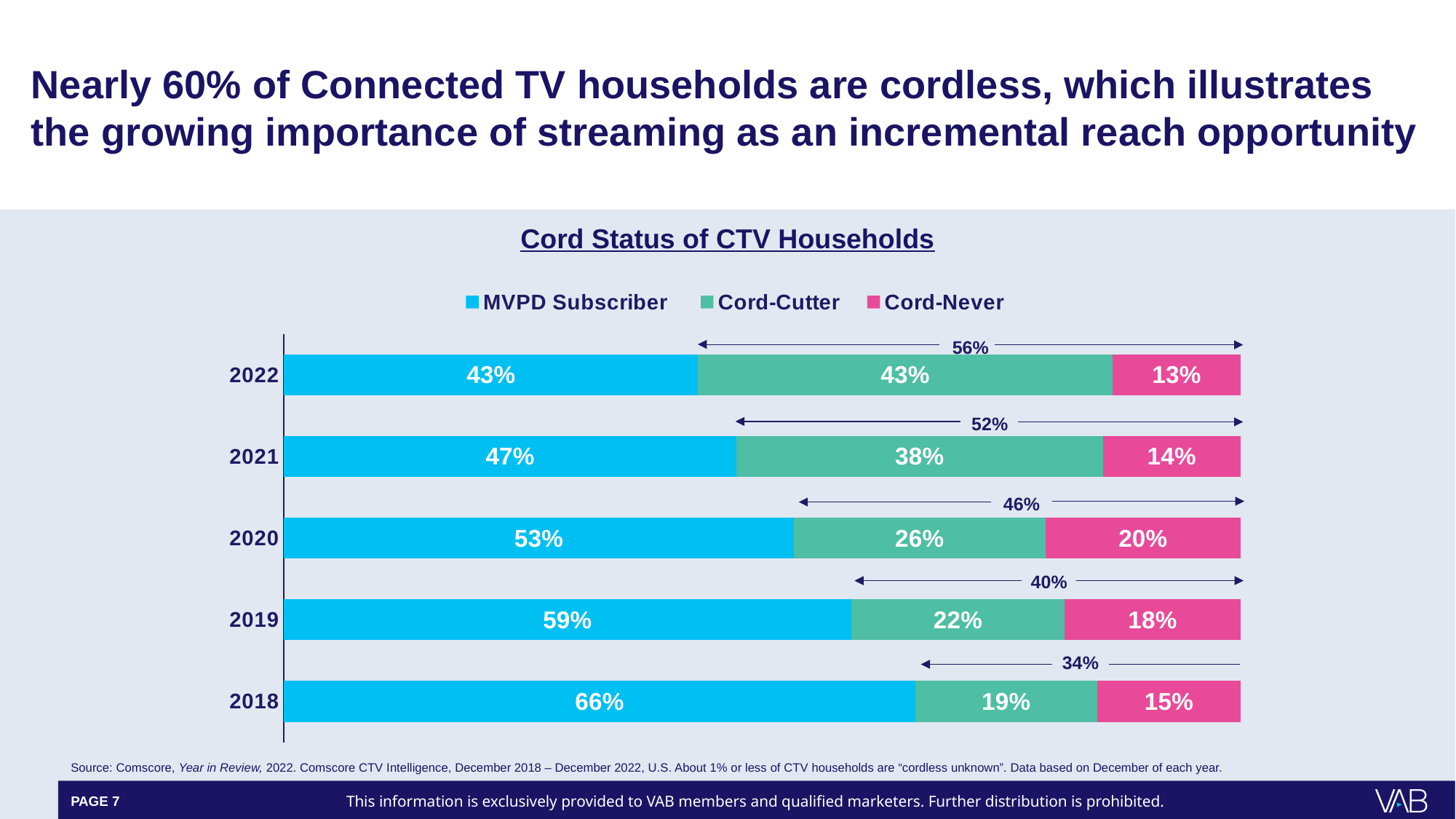
How many years are shown on the chart? 5 Which is larger in 2021: the Cord-Cutter share or the Cord-Never share? Cord-Cutter What is the MVPD Subscriber share in 2022? 43% Which year has the lowest Cord-Cutter share? 2018 What kind of chart is shown on the slide? Stacked bar chart How does the MVPD Subscriber share change from 2018 to 2022? It falls How many series does the legend list? 3 What is the difference between the MVPD Subscriber share in 2018 and in 2022? 23% What is the Cord-Never share in 2018? 15% What is the chart's title? Cord Status of CTV Households Which year has the highest MVPD Subscriber share? 2018 What is the Cord-Cutter share in 2020? 26%